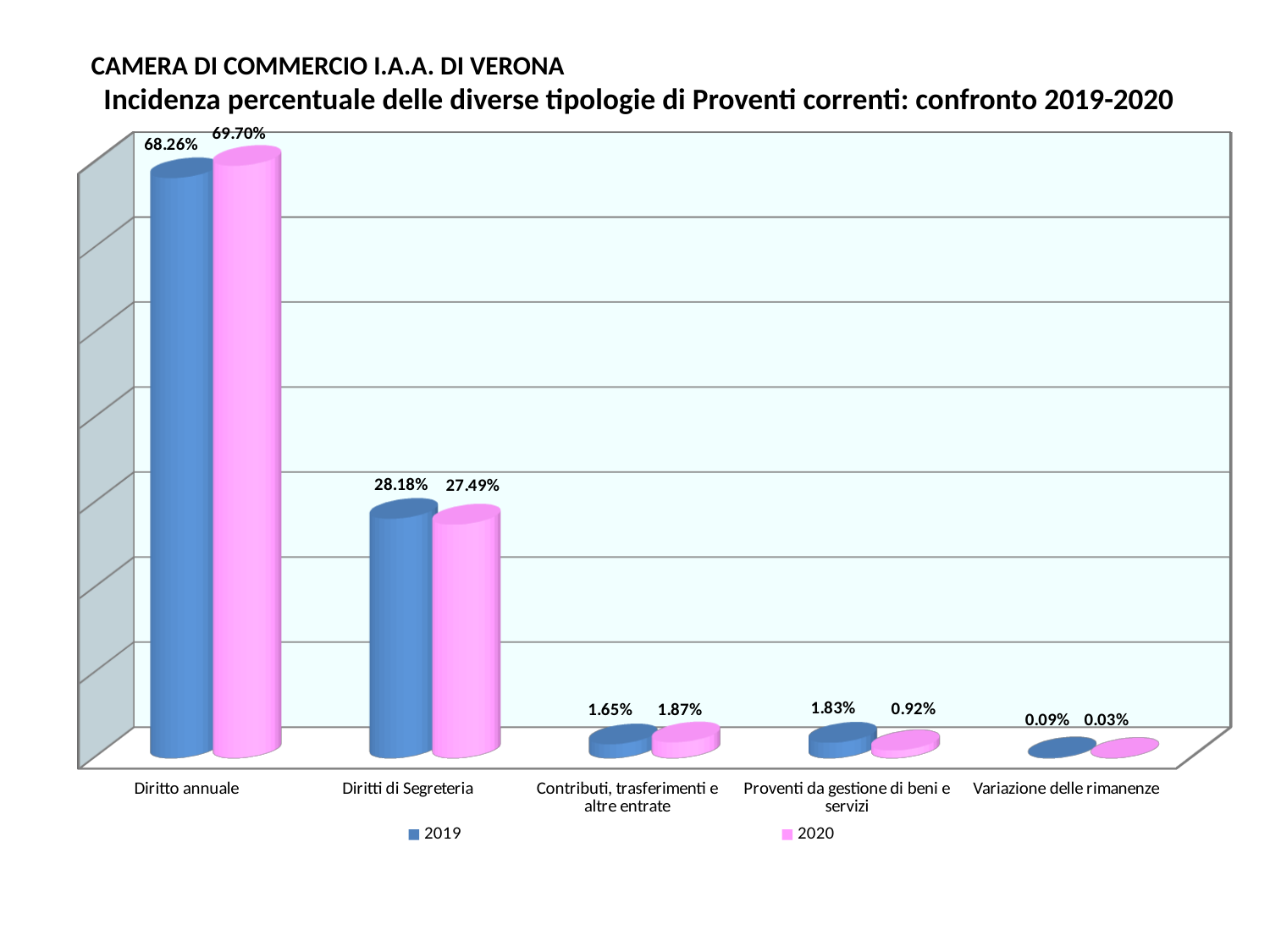
How many categories are shown on the x axis? 5 What is the value for Proventi da gestione di beni e servizi in 2020? 0.92% What is the value for Diritti di Segreteria in 2020? 27.49% What is the difference between the 2019 and 2020 values for Diritti di Segreteria? 0.69% Which category has the lowest value in 2019? Variazione delle rimanenze What is the value for Variazione delle rimanenze in 2019? 0.09% Which category has the highest value in 2020? Diritto annuale What kind of chart is shown on the slide? Bar chart What is the value for Diritto annuale in 2019? 68.26% Which is larger for Contributi, trasferimenti e altre entrate: the 2019 value or the 2020 value? 2020 How many series does the legend list? 2 What is the difference between the 2020 and 2019 values for Diritto annuale? 1.44%